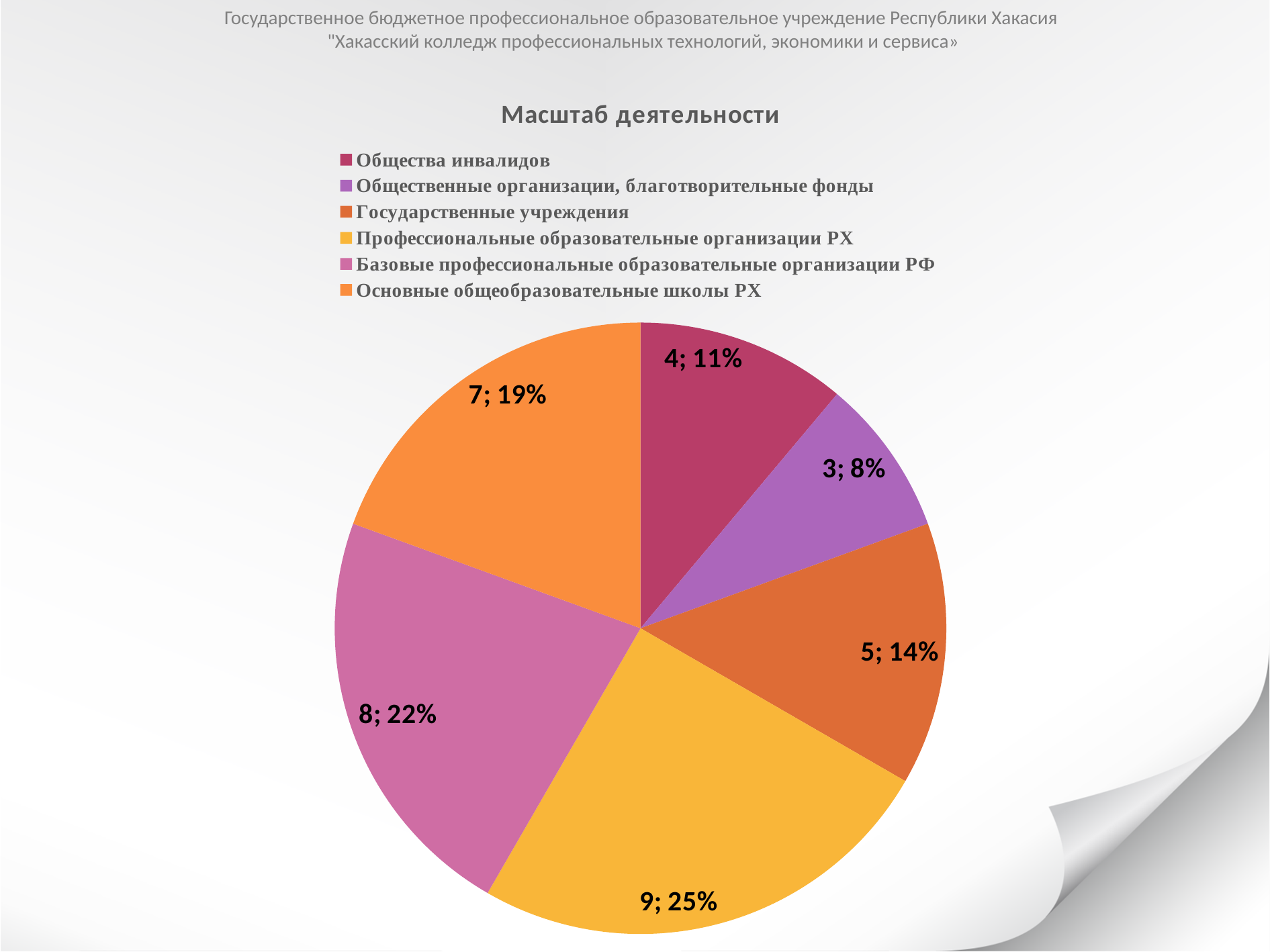
Which category has the largest slice? Профессиональные образовательные организации РХ Which is larger: the value for Основные общеобразовательные школы РХ or the value for Государственные учреждения? Основные общеобразовательные школы РХ What percentage share does Профессиональные образовательные организации РХ have? 25% What is the difference between the values for Базовые профессиональные образовательные организации РФ and Общественные организации, благотворительные фонды? 5 Which category has the smallest slice? Общественные организации, благотворительные фонды How many slices does the pie chart have? 6 What value is shown for Общества инвалидов? 4 What percentage share does Основные общеобразовательные школы РХ have? 19% What kind of chart is shown on the slide? Pie chart What value is shown for Государственные учреждения? 5 What is the title of the chart? Масштаб деятельности What is the total of all the values shown on the pie chart? 36